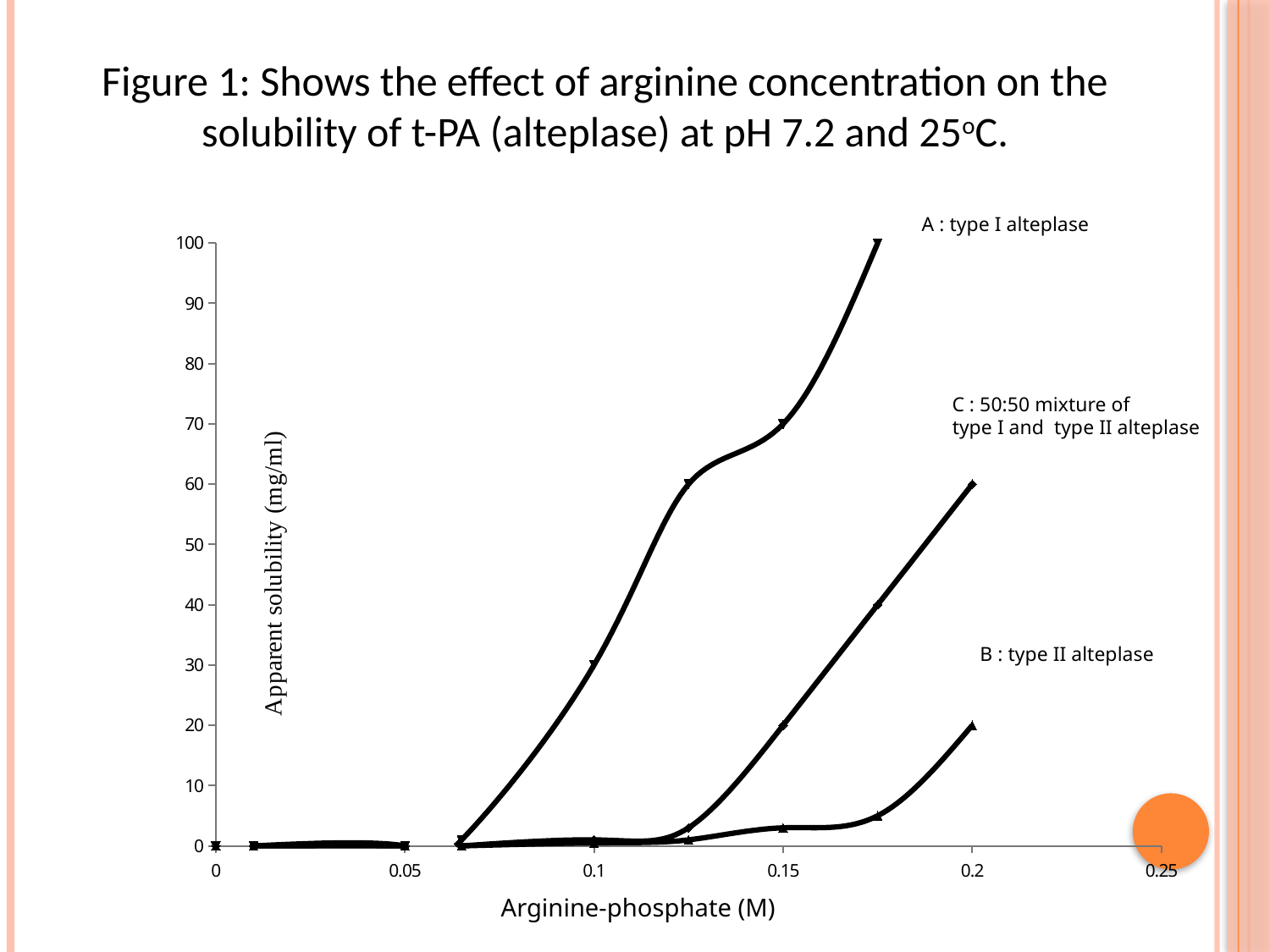
Which curve reaches the highest apparent solubility on the chart? A : type I alteplase Which curve has the lowest apparent solubility at 0.2 M arginine-phosphate? B : type II alteplase What is the apparent solubility of curve B (type II alteplase) at 0.2 M arginine-phosphate? 20 mg/ml What is the difference in apparent solubility between curve C and curve B at 0.2 M arginine-phosphate? 40 mg/ml At 0.2 M arginine-phosphate, which has the larger apparent solubility, curve B or curve C? Curve C What is the apparent solubility of curve A (type I alteplase) at 0.15 M arginine-phosphate? 70 mg/ml What is the apparent solubility of curve A (type I alteplase) at 0.1 M arginine-phosphate? 30 mg/ml How many curves (series) are plotted on the chart? 3 Does the apparent solubility of curve A rise or fall as arginine-phosphate concentration increases beyond 0.05 M? Rise What is the label of the x axis? Arginine-phosphate (M) What type of chart is shown on the slide? Line chart What is the apparent solubility of curve C (50:50 mixture) at 0.2 M arginine-phosphate? 60 mg/ml